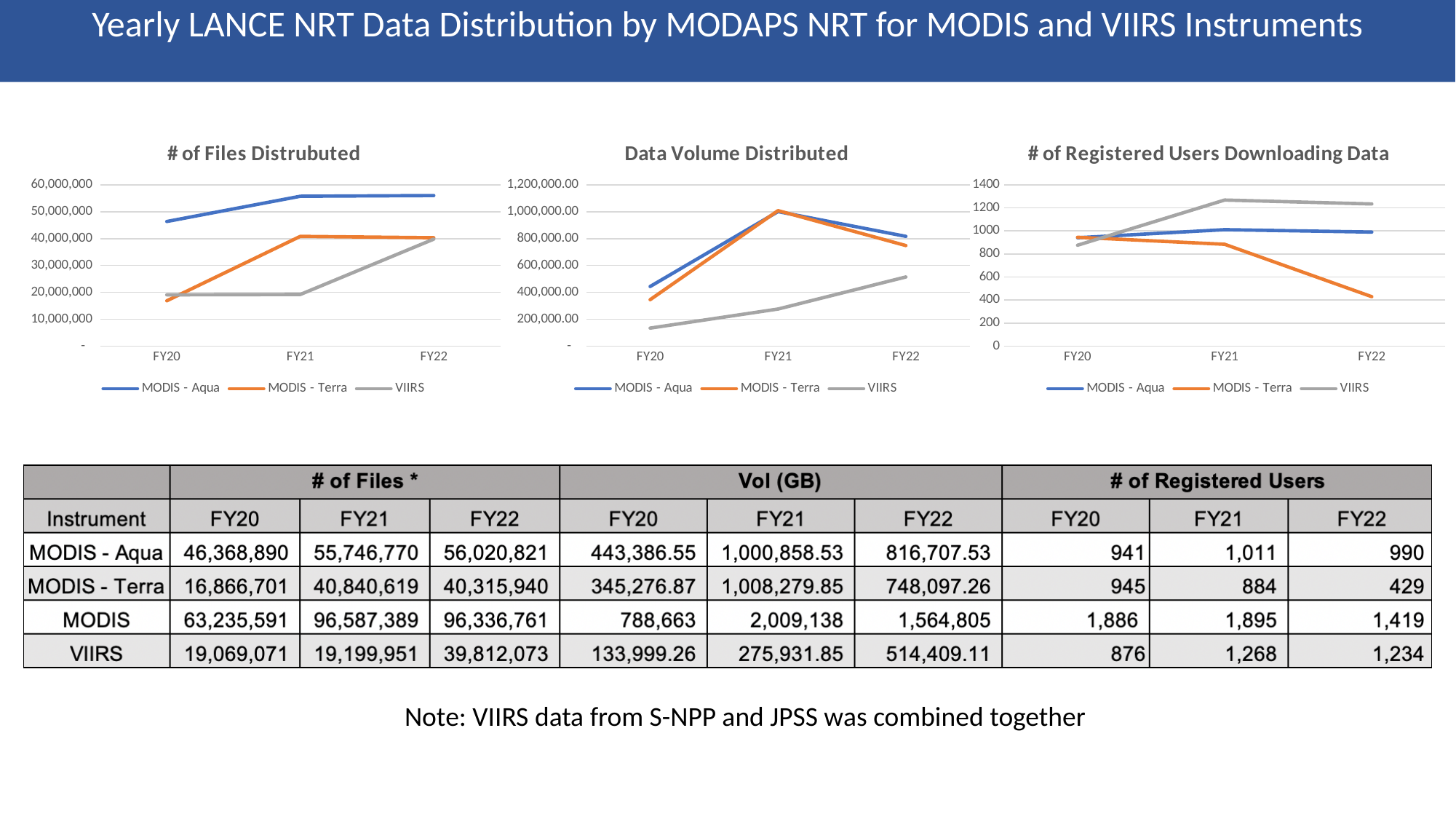
In the "Data Volume Distributed" chart, which is larger in FY21, MODIS - Aqua or VIIRS? MODIS - Aqua In the "# of Files Distrubuted" chart, what is the value for MODIS - Aqua in FY22? 56,020,821 In the "# of Files Distrubuted" chart, is the value for MODIS - Terra in FY21 greater or less than 30,000,000? greater In the "# of Registered Users Downloading Data" chart, does the MODIS - Terra line rise or fall from FY20 to FY22? fall How many series does the legend of the "Data Volume Distributed" chart list? 3 In the "# of Files Distrubuted" chart, which series has the lowest value in FY20? MODIS - Terra What type of chart is the "# of Files Distrubuted" chart? line chart In the "# of Registered Users Downloading Data" chart, which series has the highest value in FY21? VIIRS In the "Data Volume Distributed" chart, what is the value for VIIRS in FY21? 275,931.85 How many fiscal years are plotted on the x axis of the "# of Registered Users Downloading Data" chart? 3 In the "# of Registered Users Downloading Data" chart, what is the value for MODIS - Terra in FY22? 429 In the "Data Volume Distributed" chart, what is the difference between MODIS - Aqua and VIIRS in FY22? 302,298.42